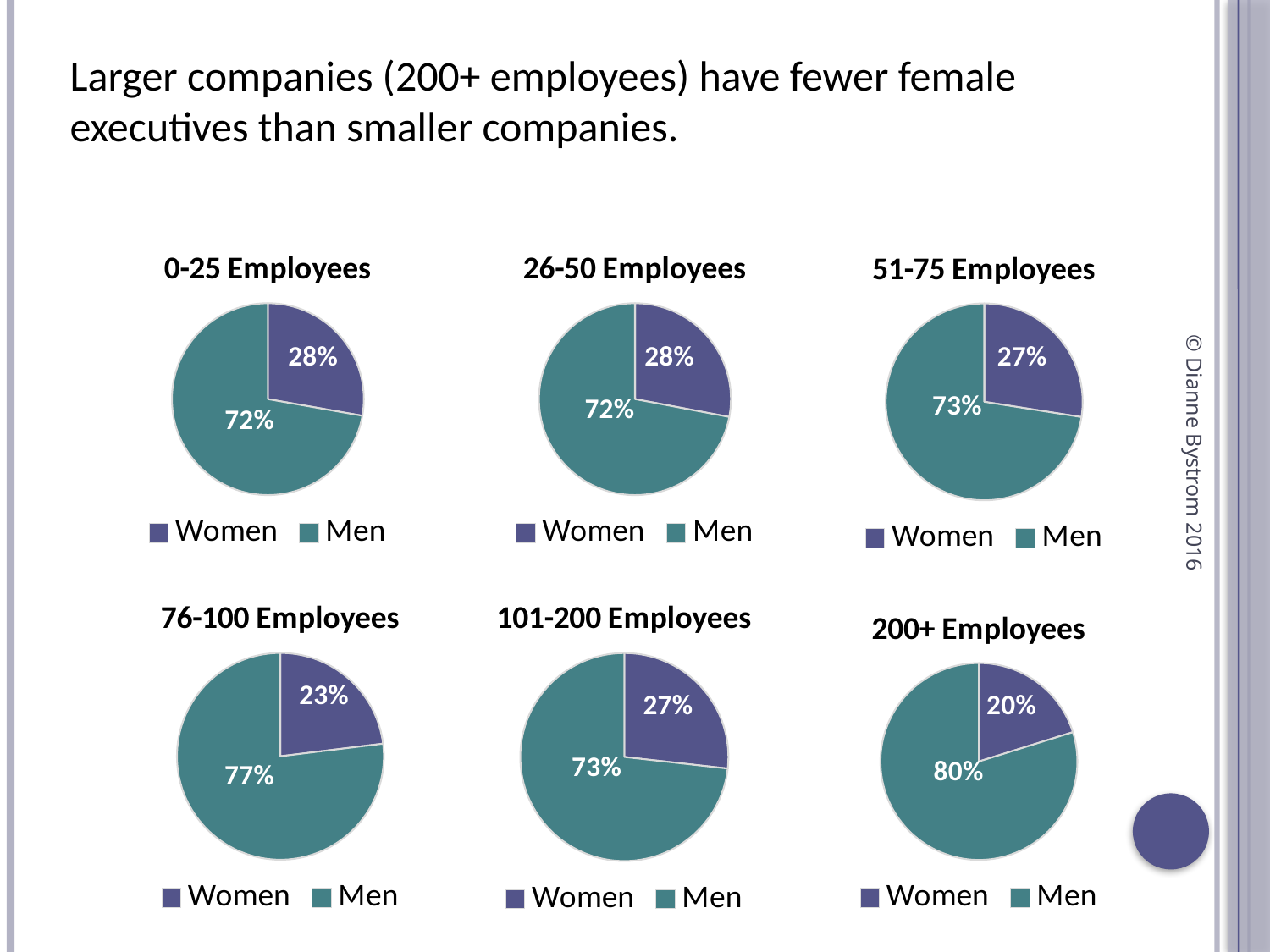
Across the six pie charts, which employee-size group has the lowest share of Women? 200+ Employees In the "101-200 Employees" pie chart, what is the difference between the Men and Women shares? 46% Across the six pie charts, which employee-size group has the highest share of Men? 200+ Employees How many pie charts are shown on the slide? 6 In the "200+ Employees" pie chart, what share is Men? 80% In the "76-100 Employees" pie chart, what share is Women? 23% Is the Women share larger in the "26-50 Employees" chart or the "76-100 Employees" chart? 26-50 Employees How many series does the legend of the "0-25 Employees" chart list? 2 In the "0-25 Employees" pie chart, what share is Women? 28% In the "26-50 Employees" pie chart, which colour represents Men? Teal In the "51-75 Employees" pie chart, what share is Men? 73% What kind of chart is used for the "200+ Employees" data? Pie chart